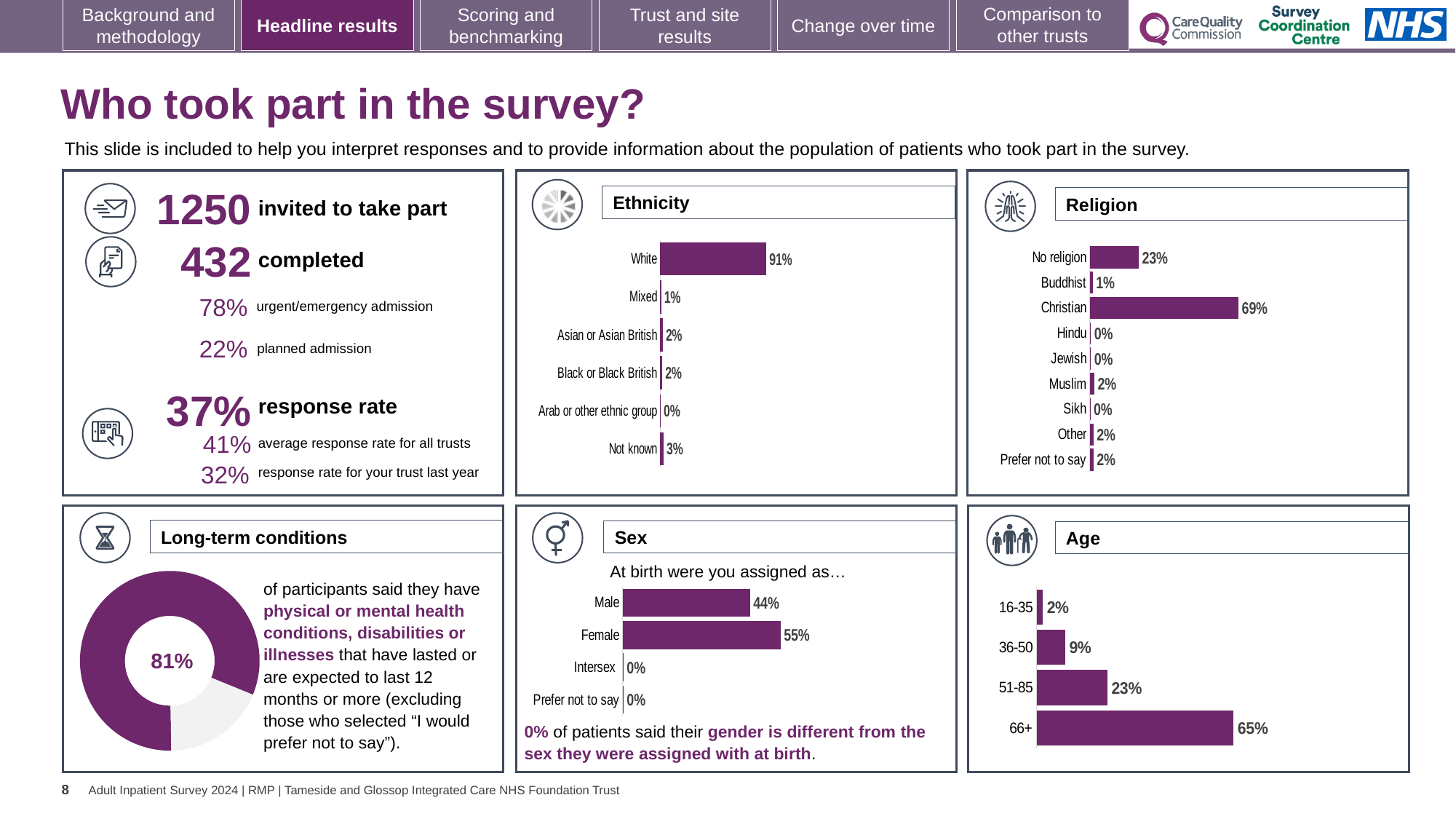
In the Age chart, do the values rise or fall from 16-35 to 66+? Rise In the Sex chart, which is larger, Male or Female? Female In the Ethnicity chart, what percentage of respondents were White? 91% How many categories does the Religion chart show? 9 In the Long-term conditions chart, what share of participants said they have physical or mental health conditions, disabilities or illnesses? 81% In the Age chart, which age group has the lowest value? 16-35 In the Age chart, what is the difference between the 66+ and 51-85 values? 42% How many categories does the Ethnicity chart show? 6 In the Religion chart, what is the value for No religion? 23% What kind of chart is the Long-term conditions chart? Doughnut chart In the Religion chart, which category has the highest value? Christian In the Sex chart, what is the value for Intersex? 0%